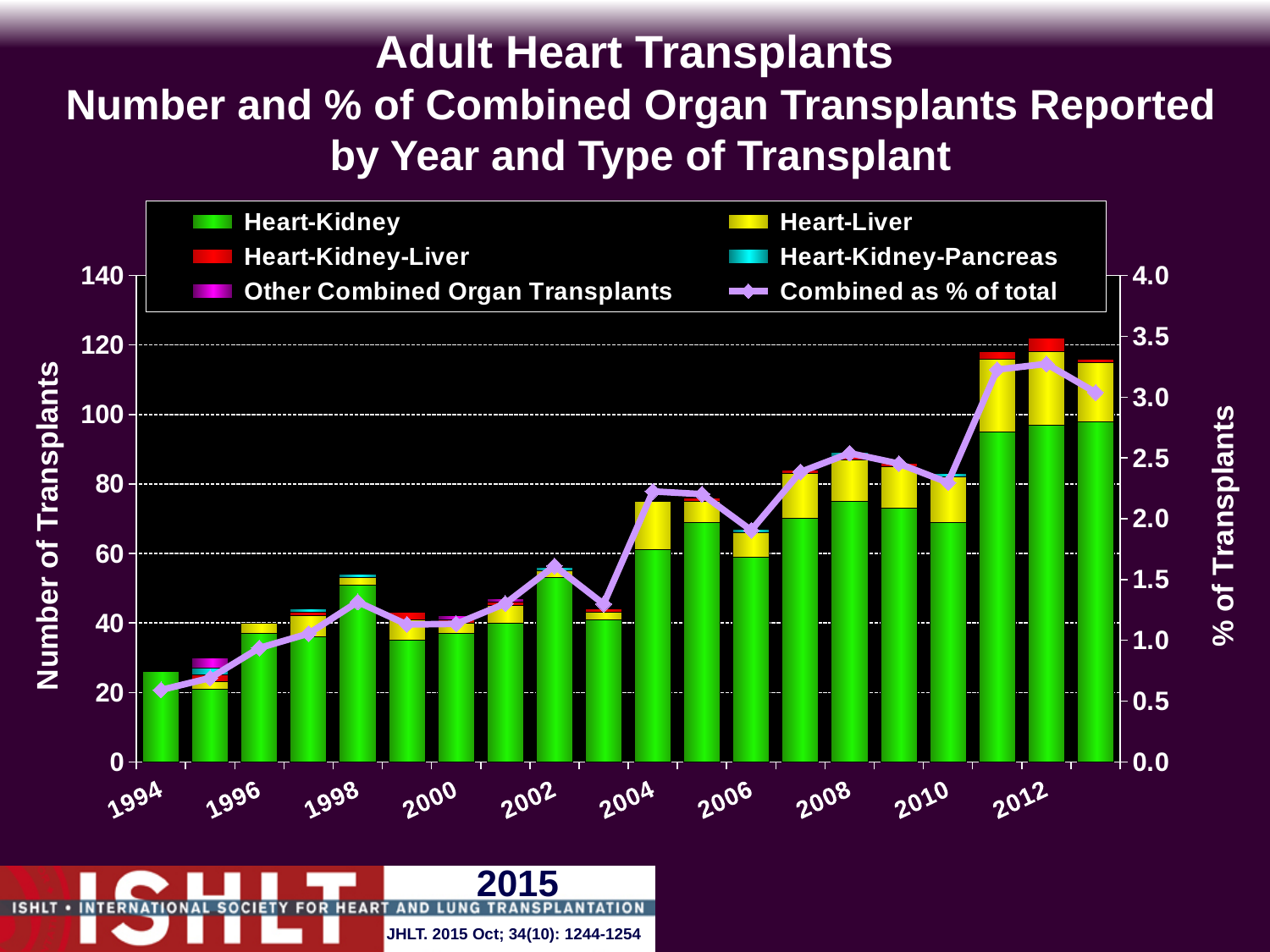
Is the 'Combined as % of total' value for 2012 greater or less than 3.0? greater How many series does the legend list? 6 Is the total number of transplants for 2004 greater or less than 60? greater Is the 'Combined as % of total' value for 1994 greater or less than 1.0? less What is the label of the right-hand y axis? % of Transplants Which year has a taller stacked bar, 2004 or 2006? 2004 Overall, does the number of combined organ transplants rise or fall from 1994 to 2013? rise What kind of chart is shown on the slide? Stacked bar chart with a line How many years (bars) are plotted on the x axis? 20 Which year has the tallest stacked bar for number of transplants? 2012